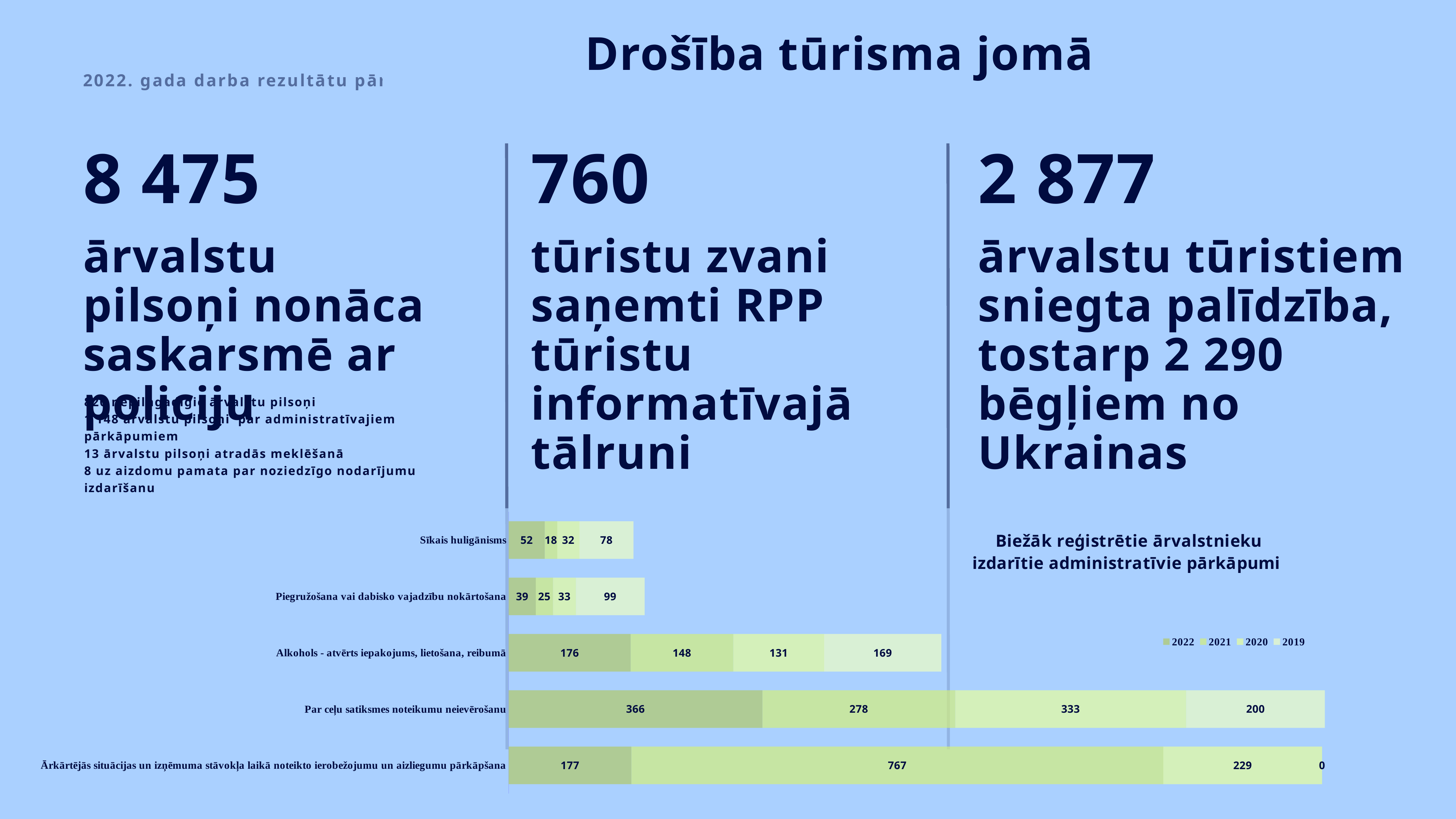
Which category has the highest 2022 value? Par ceļu satiksmes noteikumu neievērošanu How many series does the chart legend list? 4 What type of chart is shown on the slide? stacked bar chart What is the 2020 value for 'Alkohols - atvērts iepakojums, lietošana, reibumā'? 131 How many categories are plotted in the chart? 5 What is the 2022 value for 'Par ceļu satiksmes noteikumu neievērošanu'? 366 What is the difference between the 2022 and 2021 values for 'Par ceļu satiksmes noteikumu neievērošanu'? 88 What is the total of the stacked bar for 'Alkohols - atvērts iepakojums, lietošana, reibumā'? 624 Which category has the lowest 2019 value? Ārkārtējās situācijas un izņēmuma stāvokļa laikā noteikto ierobežojumu un aizliegumu pārkāpšana What is the 2019 value for 'Sīkais huligānisms'? 78 What is the 2021 value for 'Ārkārtējās situācijas un izņēmuma stāvokļa laikā noteikto ierobežojumu un aizliegumu pārkāpšana'? 767 What is the title of the chart? Biežāk reģistrētie ārvalstnieku izdarītie administratīvie pārkāpumi